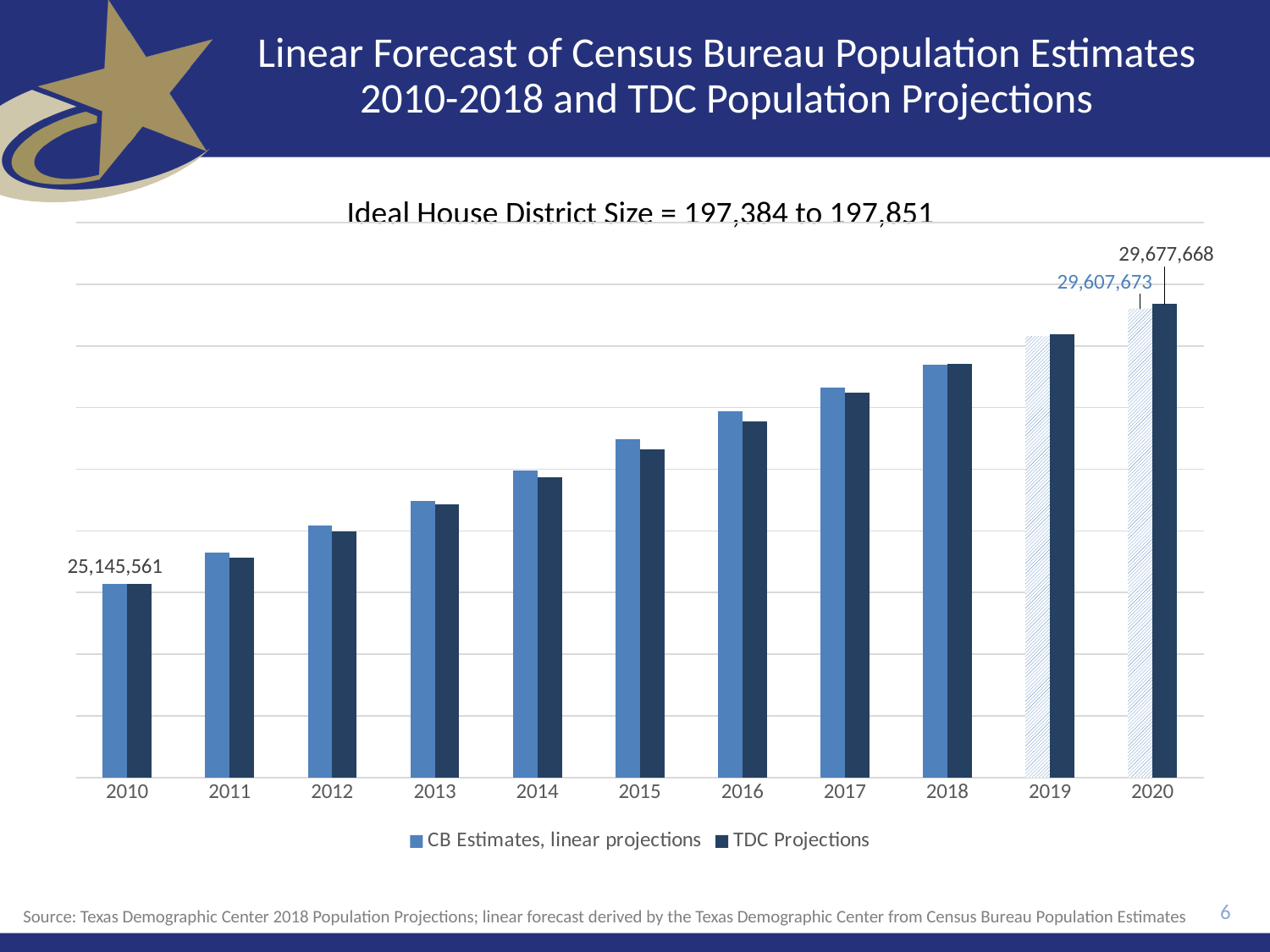
What kind of chart is shown on the slide? bar chart What is the CB Estimates, linear projections value for 2020? 29,607,673 What is the difference between the TDC Projections value and the CB Estimates value for 2020? 69,995 What is the title shown above the chart? Ideal House District Size = 197,384 to 197,851 What value is labeled on the chart for 2010? 25,145,561 For 2020, which series has the larger value, CB Estimates, linear projections or TDC Projections? TDC Projections How many series does the legend list? 2 For 2015, which series has the larger value, CB Estimates, linear projections or TDC Projections? CB Estimates, linear projections Do the values rise or fall from 2010 to 2020? rise How many years are shown along the x axis? 11 What is the TDC Projections value for 2020? 29,677,668 Which year has the highest TDC Projections value? 2020